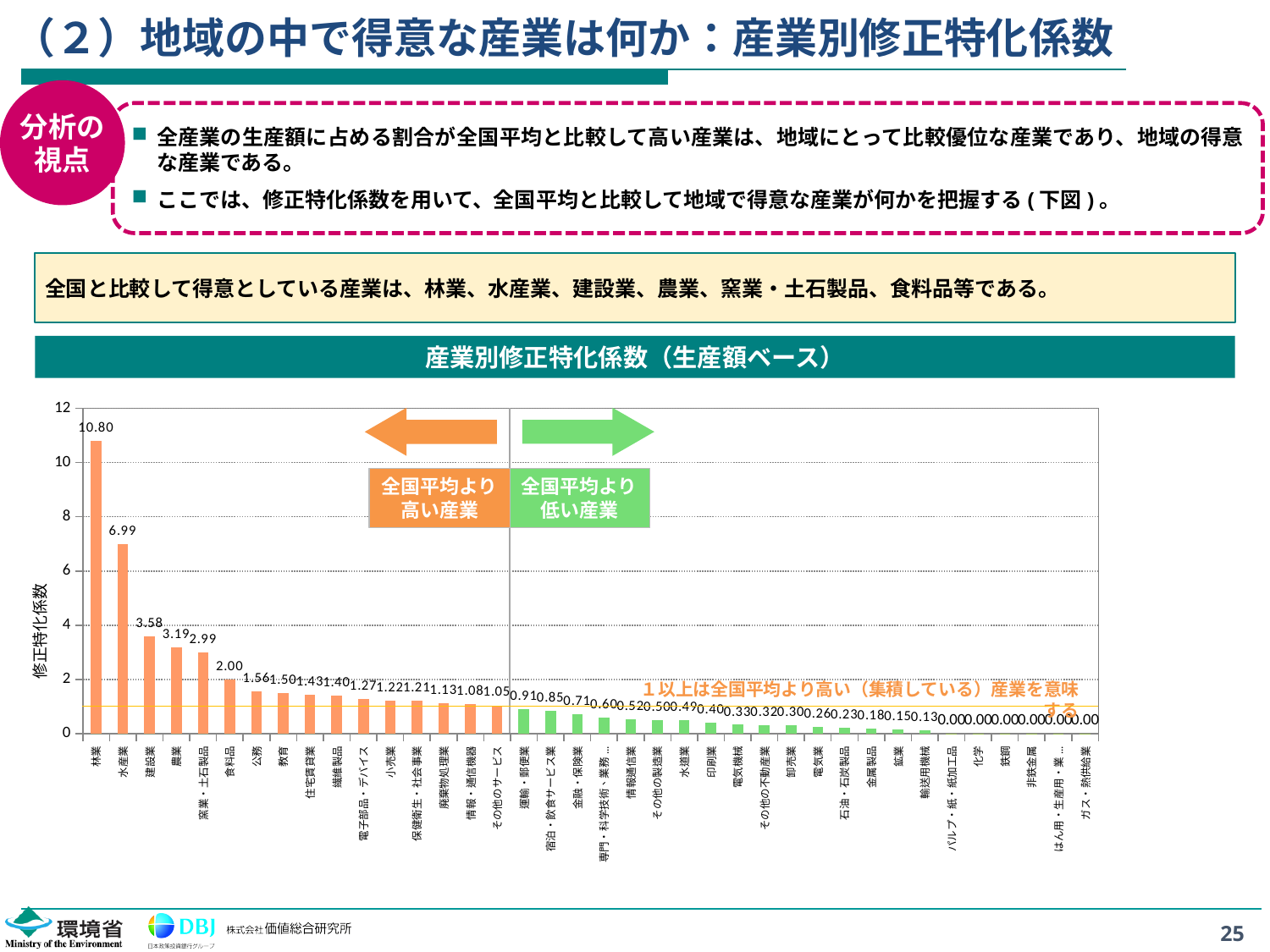
What is the 修正特化係数 value for 林業? 10.80 What is the value shown for 食料品? 2.00 Which industry has the highest 修正特化係数? 林業 What is the difference between the values for 林業 and 水産業? 3.81 What kind of chart is shown on the slide? bar chart What is the label of the y axis? 修正特化係数 What is the value shown for 水産業? 6.99 Is the value for 水産業 greater or less than 6? greater Which has a larger value, 農業 or 窯業・土石製品? 農業 What is the value shown for 建設業? 3.58 Do the values rise or fall moving from left to right along the x axis? fall What is the title of the chart? 産業別修正特化係数（生産額ベース）